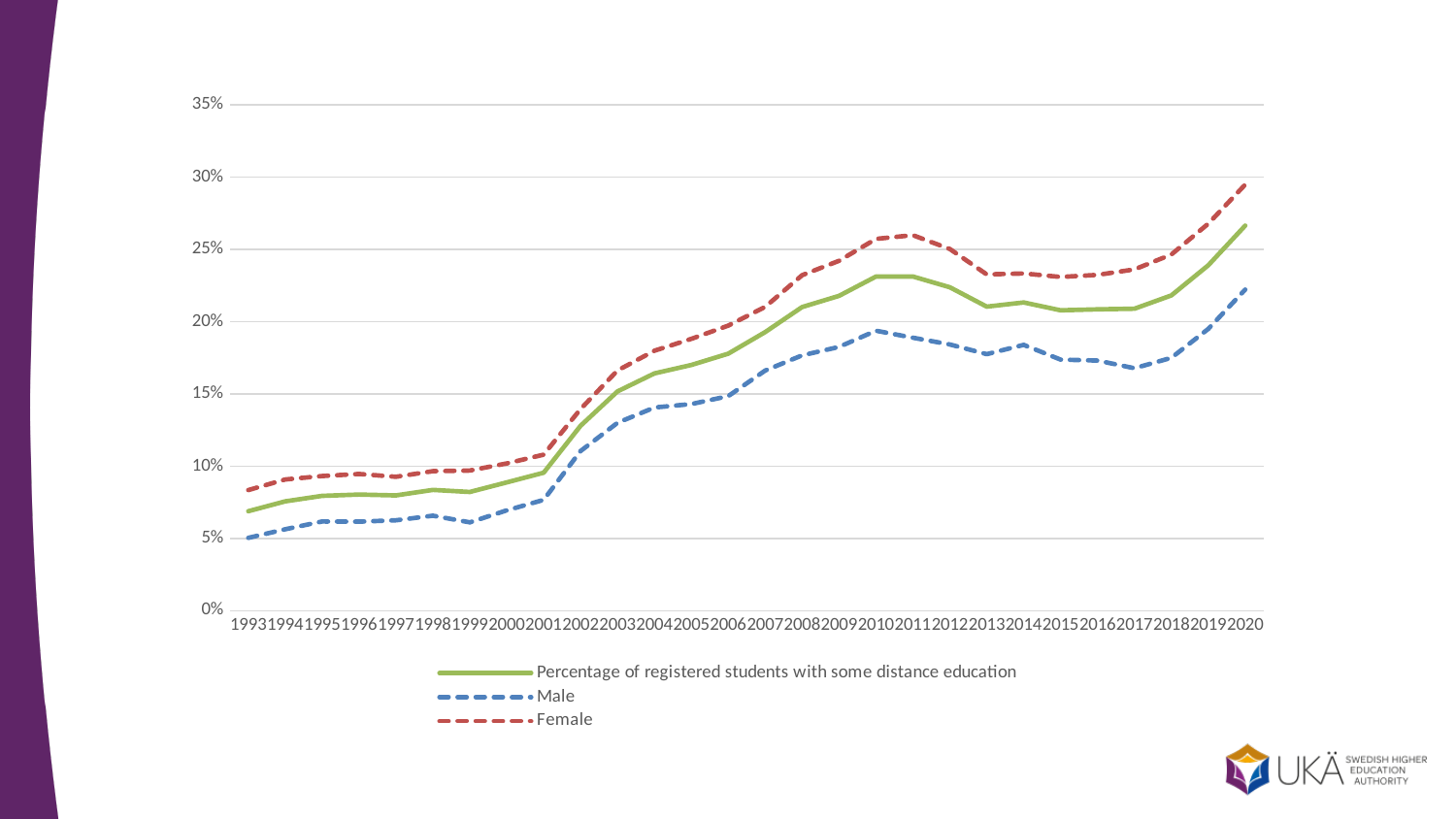
Do the values for Female rise or fall overall from 1993 to 2020? rise Is the value for Male in 1993 greater or less than 10%? less How many series does the legend list? 3 Is the value for Percentage of registered students with some distance education in 2010 greater or less than 20%? greater In which year does the Female series reach its highest value? 2020 What kind of chart is shown on the slide? line chart In which year does the Male series have its lowest value? 1993 Which is larger, the value for Male in 2011 or the value for Male in 2017? 2011 Which series is drawn as a solid green line? Percentage of registered students with some distance education In 2020, which is larger, the value for Female or the value for Male? Female Is the value for Female in 2020 greater or less than 25%? greater How many years are plotted along the x axis? 28